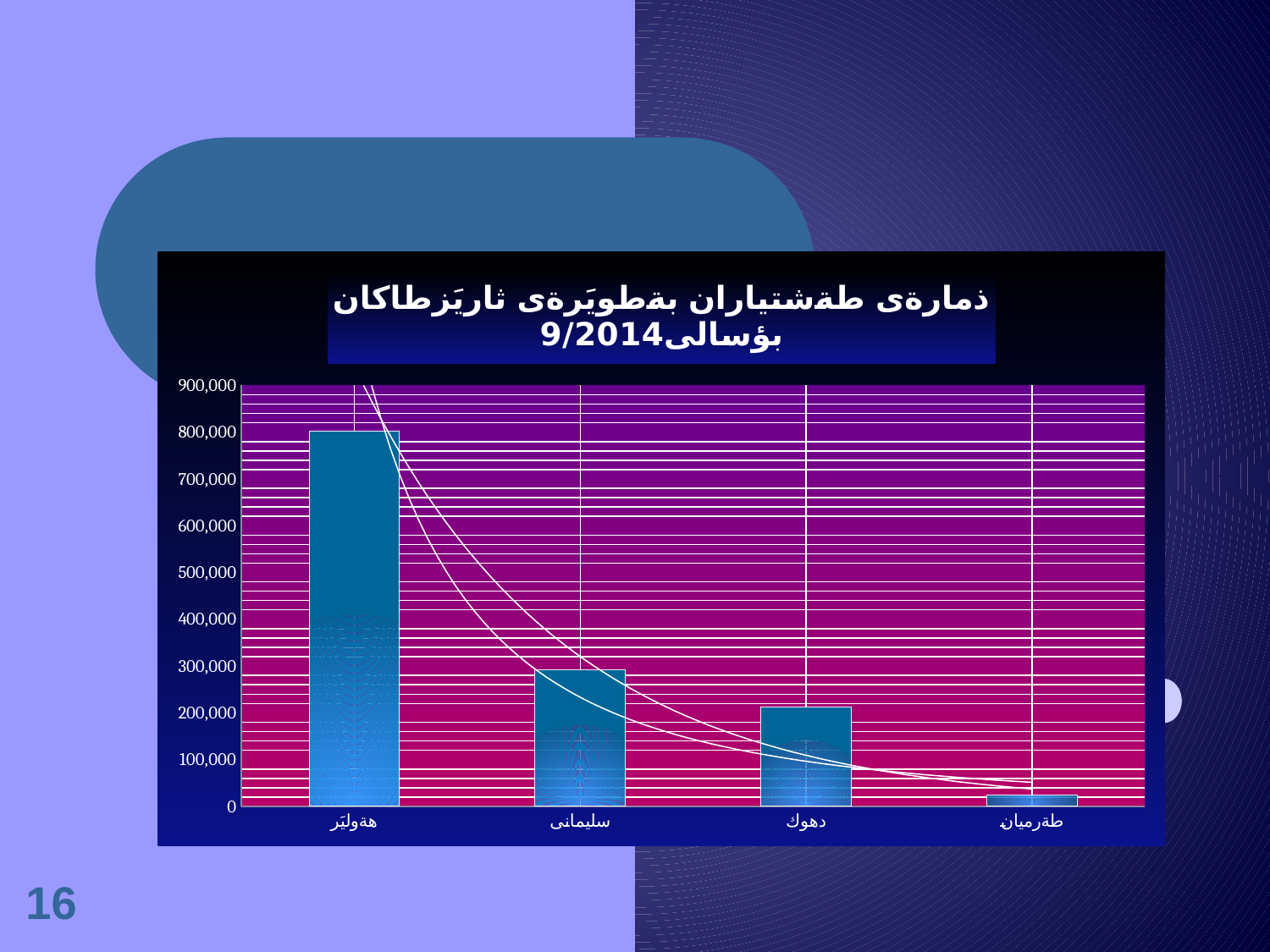
Which has a larger value, سليمانى or دهوك? سليمانى Is the value for هةولێر greater or less than 700,000? greater Which category has the highest value in the chart? هةوليَر Is the value for طةرميان greater or less than 100,000? less Is the value for دهوك greater or less than 300,000? less Do the bar values rise or fall from left to right along the x axis? fall Which category has the lowest value in the chart? طةرميان Which has a larger value, دهوك or طةرميان? دهوك How many categories are shown on the x axis of the chart? 4 What kind of chart is shown on the slide? bar chart What is the highest value shown on the chart's vertical axis? 900,000